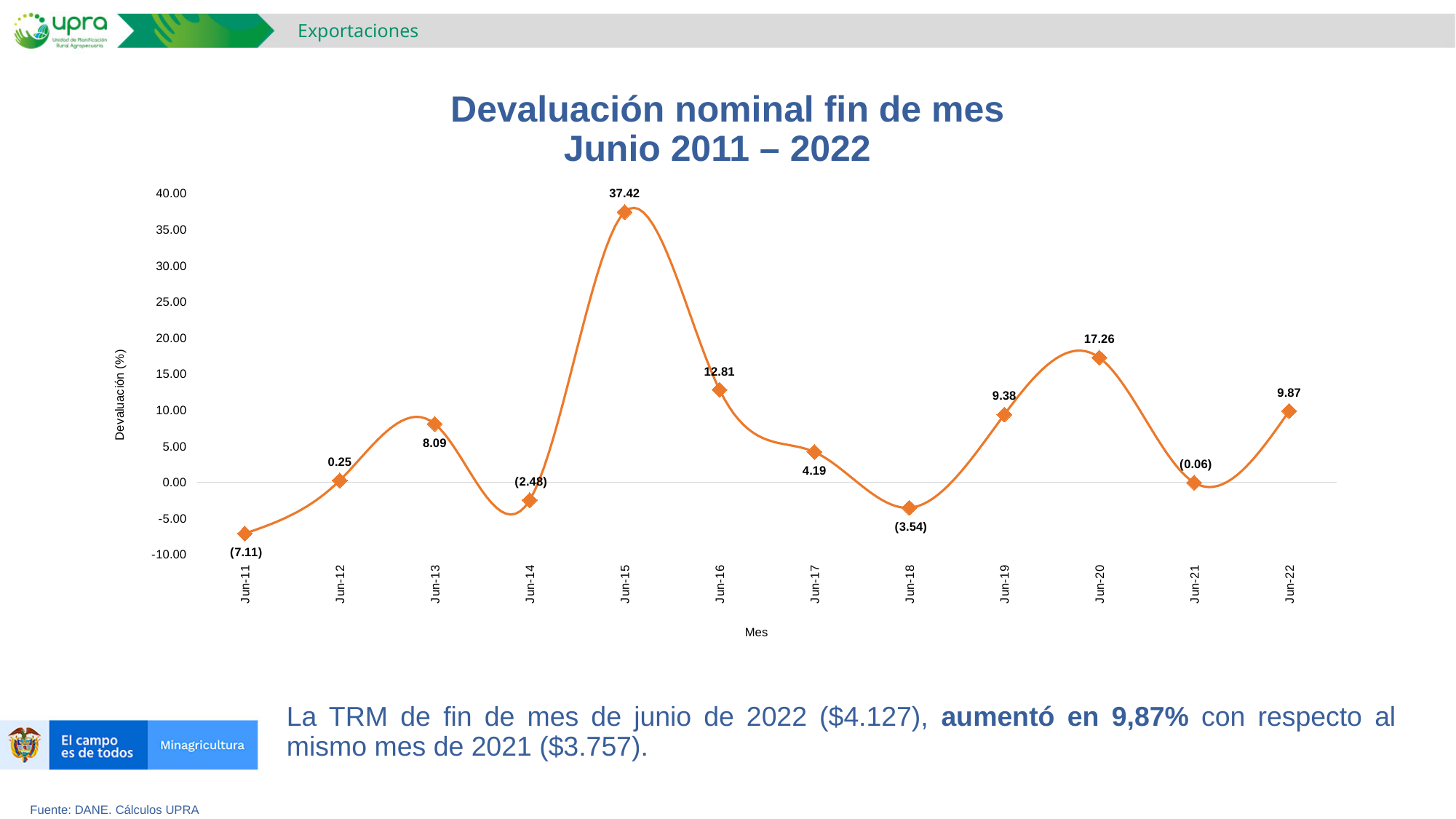
Which month has the highest value? Jun-15 What is the value for Jun-22? 9.87 What is the title of the chart? Devaluación nominal fin de mes Junio 2011 – 2022 How many data points are plotted on the chart? 12 What is the value for Jun-18? (3.54) Is the value for Jun-20 greater or less than 15.00? greater What is the difference between the values for Jun-20 and Jun-19? 7.88 What kind of chart is shown? line chart What is the value for Jun-11? (7.11) Which month has the lowest value? Jun-11 Which is larger, the value for Jun-16 or the value for Jun-13? Jun-16 What is the value for Jun-15? 37.42